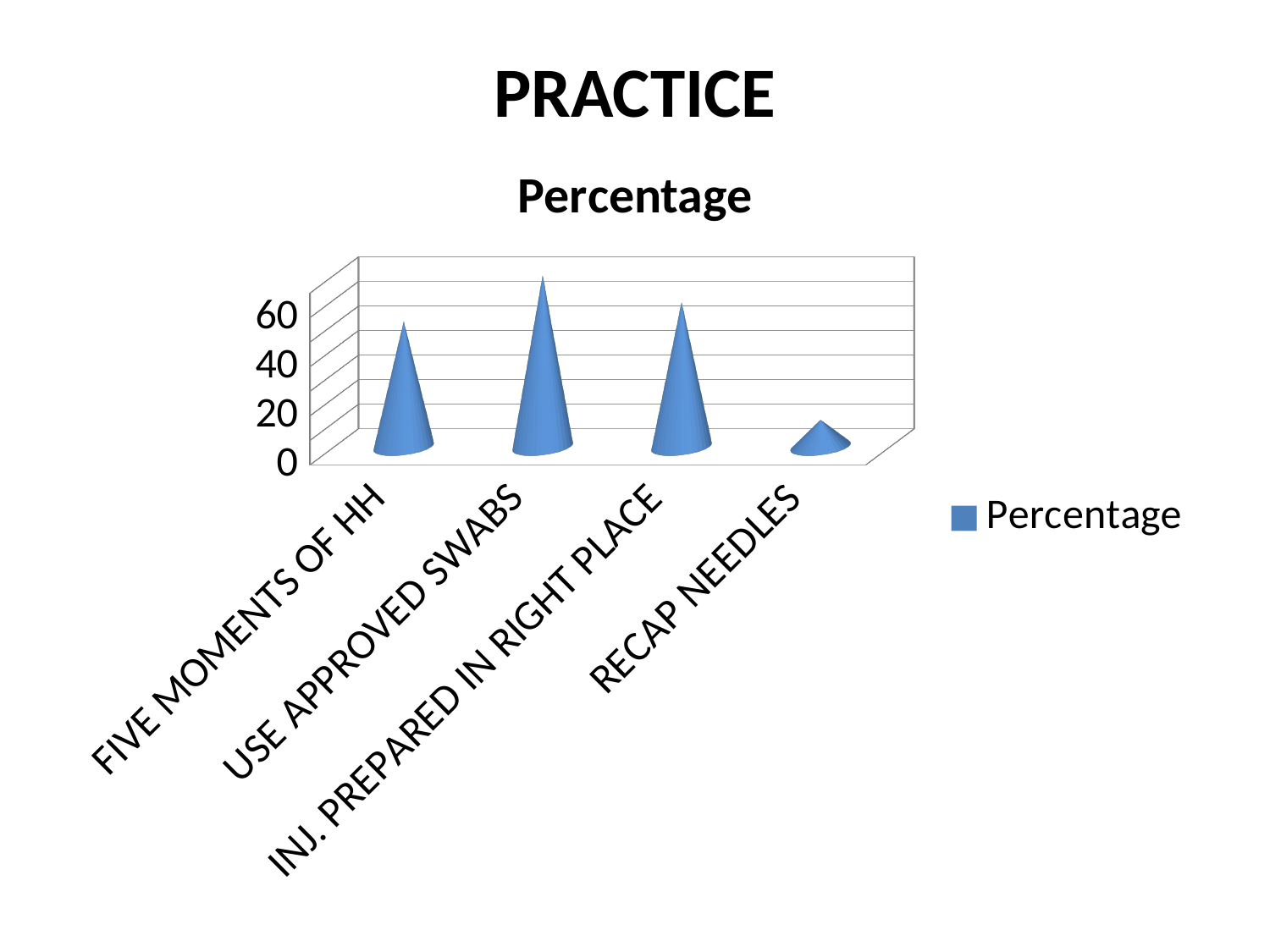
Which category has the highest value? USE APPROVED SWABS Which is larger, the value for USE APPROVED SWABS or the value for FIVE MOMENTS OF HH? USE APPROVED SWABS What kind of chart is shown on the slide? bar chart What is the title of the chart? Percentage Is the value for FIVE MOMENTS OF HH greater or less than 20? greater Is the value for RECAP NEEDLES greater or less than 20? less Which is larger, the value for USE APPROVED SWABS or the value for RECAP NEEDLES? USE APPROVED SWABS What series name is shown in the legend? Percentage How many categories are plotted on the chart? 4 Which category has the lowest value? RECAP NEEDLES Is the value for USE APPROVED SWABS greater or less than 40? greater How many series does the legend list? 1